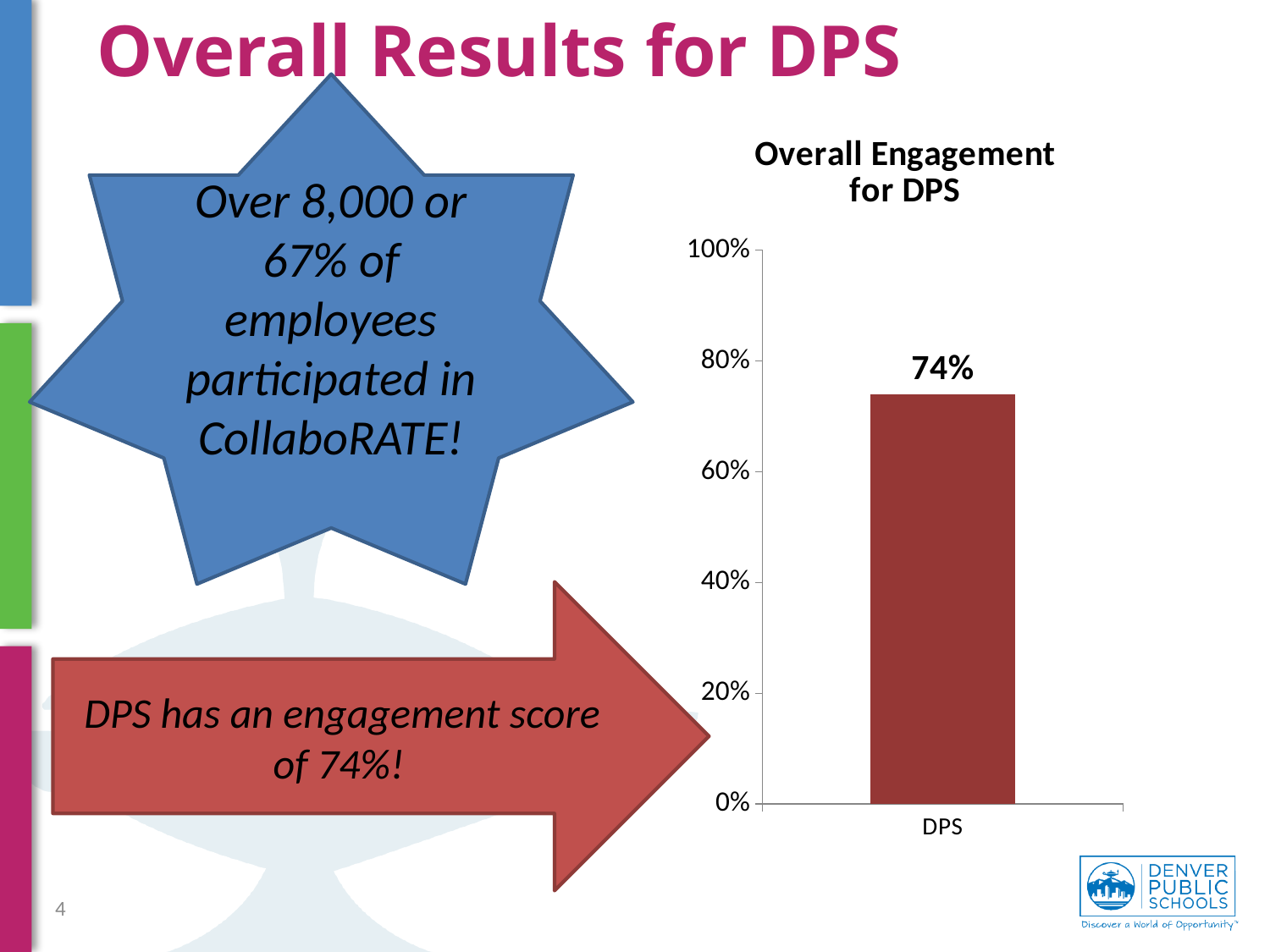
How many bars are plotted in the chart? 1 What is the highest value shown on the vertical axis of the chart? 100% What is the value for DPS in the Overall Engagement for DPS chart? 74% What is the category label on the x axis of the chart? DPS Is the value for DPS greater or less than 60%? greater Is the value for DPS greater or less than 80%? less What kind of chart is shown on the slide? bar chart What is the title of the chart? Overall Engagement for DPS